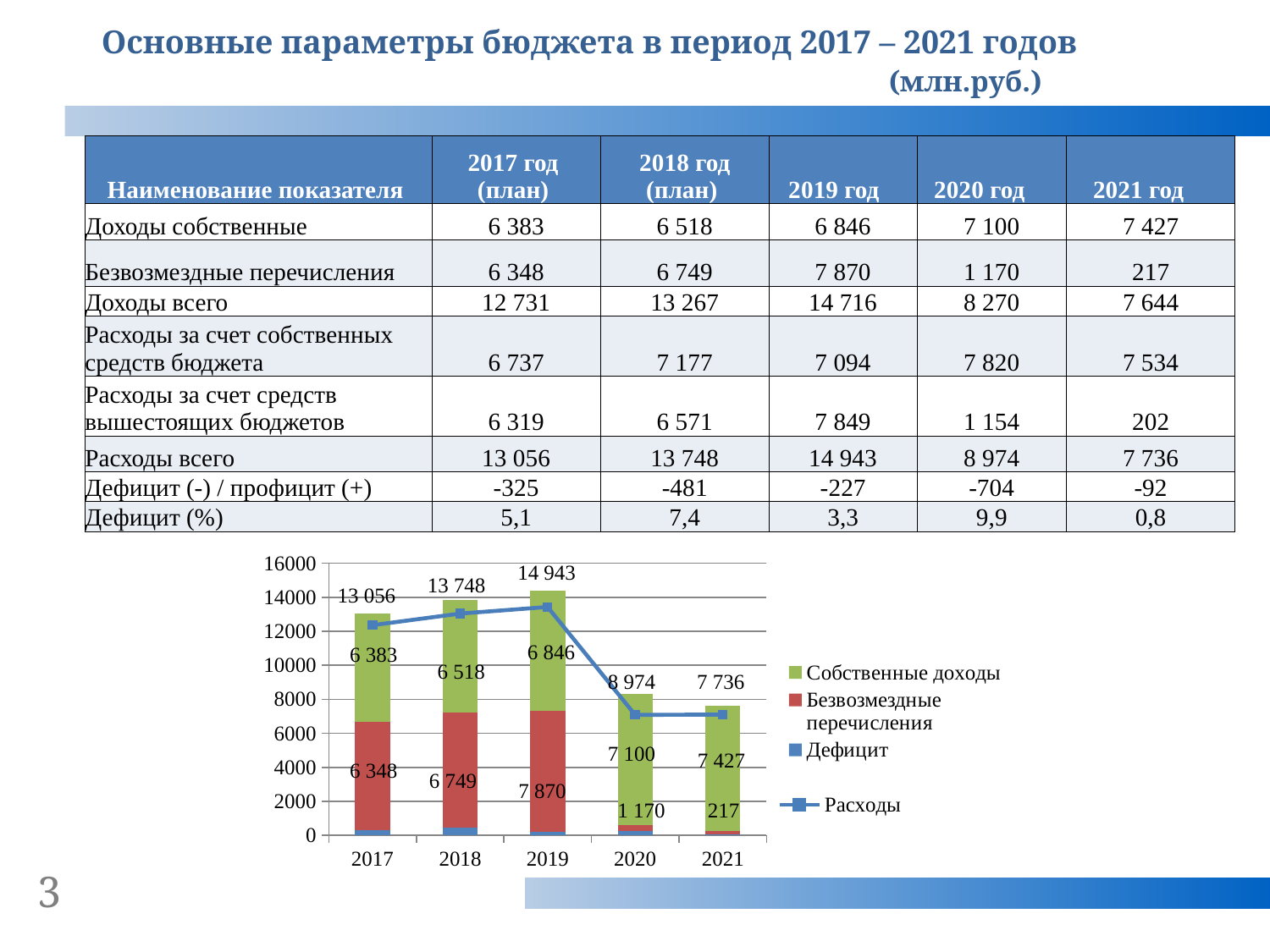
What is the difference between Собственные доходы in 2021 and in 2017? 1 044 What is the value of Безвозмездные перечисления for 2021 in the chart? 217 What type of chart is shown on the slide? Stacked bar chart with a line How many series does the chart legend list? 4 Which series in the chart is shown in green? Собственные доходы How many years are shown on the x axis of the chart? 5 What is the value of Собственные доходы for 2019 in the chart? 6 846 Which is larger in 2020: Собственные доходы or Безвозмездные перечисления? Собственные доходы In which year is Безвозмездные перечисления highest in the chart? 2019 What is the value of Расходы for 2018 in the chart? 13 748 In which year is Расходы lowest in the chart? 2021 Do the values of Собственные доходы rise or fall from 2017 to 2021? Rise